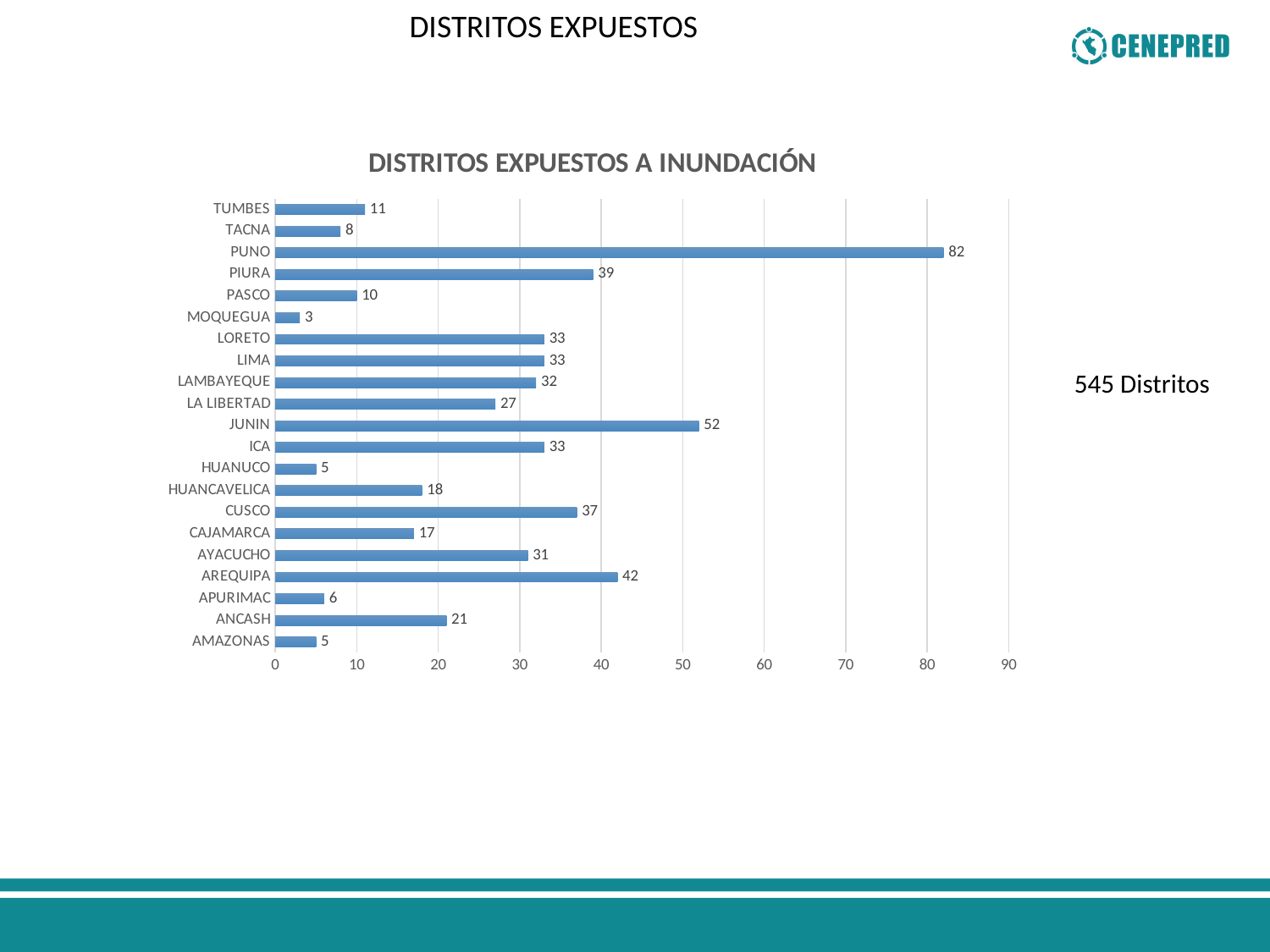
What is the value for PUNO? 82 What is the difference between the values for PUNO and JUNIN? 30 How many categories are shown on the chart? 21 What is the value for MOQUEGUA? 3 What is the difference between the values for AREQUIPA and AYACUCHO? 11 What is the title of the chart? DISTRITOS EXPUESTOS A INUNDACIÓN What kind of chart is this? Bar chart What is the value for AREQUIPA? 42 Which is larger, the value for PIURA or the value for CUSCO? PIURA Which category has the highest value? PUNO Is the value for ANCASH greater or less than 20? greater Which category has the lowest value? MOQUEGUA